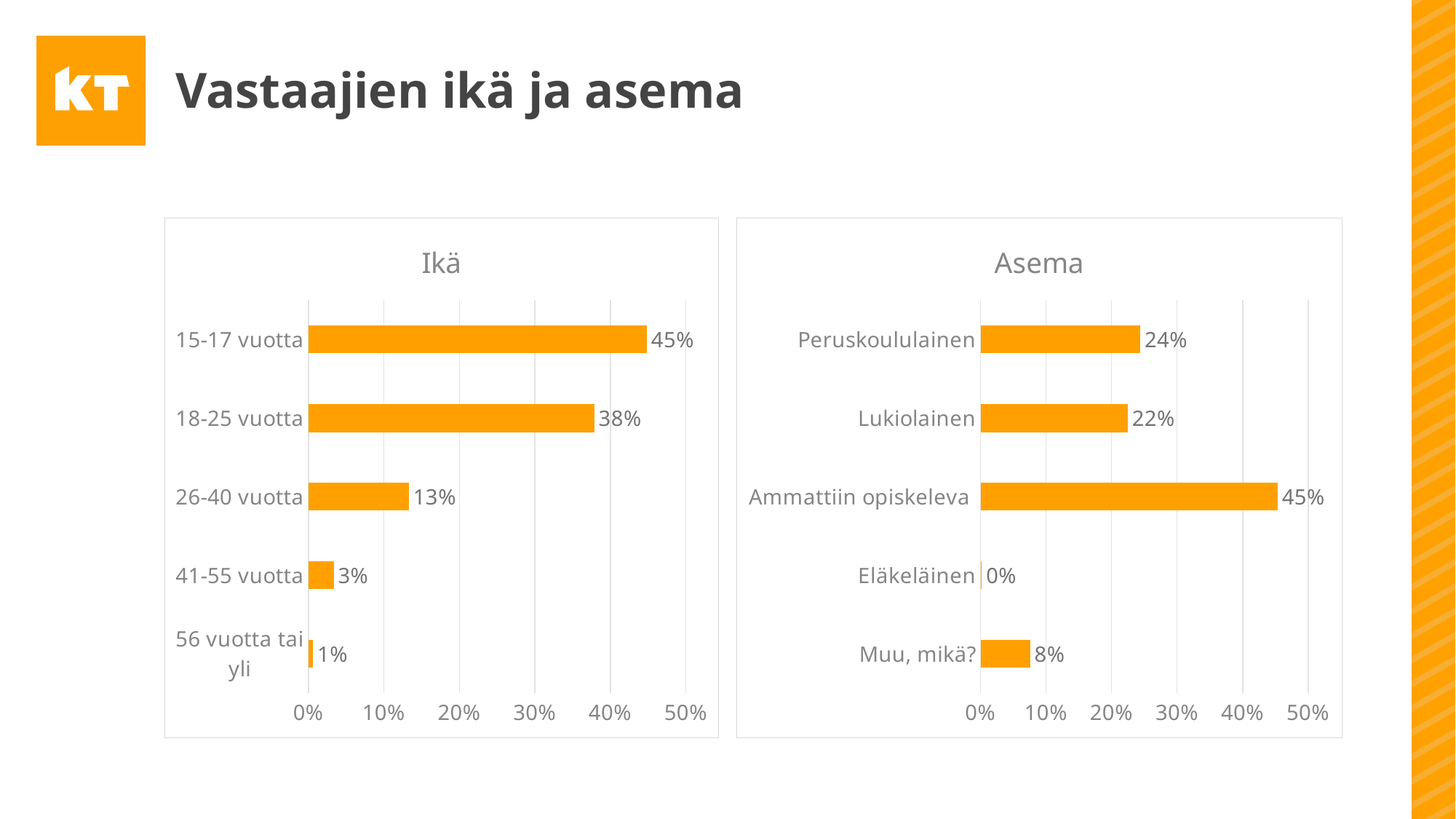
In the "Ikä" chart, what is the difference between 15-17 vuotta and 18-25 vuotta? 7% In the "Asema" chart, which is larger, Peruskoululainen or Muu, mikä? Peruskoululainen In the "Asema" chart, which category has the lowest value? Eläkeläinen What kind of chart is the "Asema" chart? bar chart In the "Ikä" chart, what is the value for 15-17 vuotta? 45% In the "Asema" chart, what is the value for Lukiolainen? 22% In the "Ikä" chart, which age group has the lowest value? 56 vuotta tai yli In the "Ikä" chart, how many age categories are shown? 5 In the "Ikä" chart, what is the value for 26-40 vuotta? 13% In the "Asema" chart, what is the difference between Ammattiin opiskeleva and Peruskoululainen? 21% In the "Ikä" chart, do the values rise or fall going down from 15-17 vuotta to 56 vuotta tai yli? fall In the "Asema" chart, which category has the highest value? Ammattiin opiskeleva